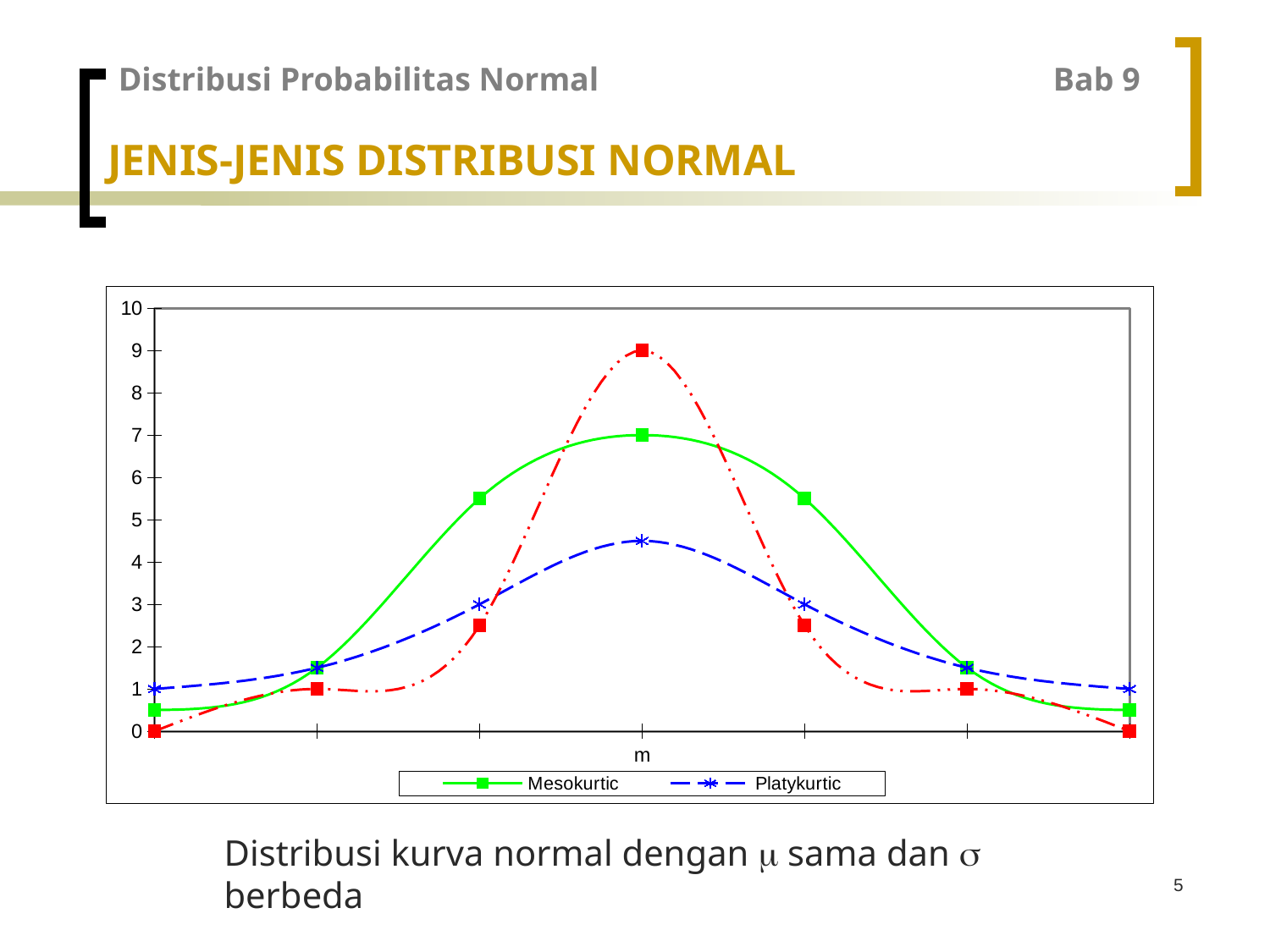
What is the highest value shown on the y axis? 10 How many series does the legend list? 2 Is the value of the Mesokurtic series at the leftmost point greater or less than 1? less At the center point m, which series is higher, Mesokurtic or Platykurtic? Mesokurtic What is the value of the Mesokurtic series at the center point labelled m? 7 Does the Mesokurtic series rise or fall from the leftmost point to the center point m? rise What is the value of the Platykurtic series at the leftmost point? 1 How many marked data points does the Mesokurtic series have? 7 What is the value of the Platykurtic series at the third point from the left? 3 What kind of chart is shown on the slide? line chart What label appears on the x axis at the center of the chart? m Is the value of the Platykurtic series at the center point m greater or less than 4? greater